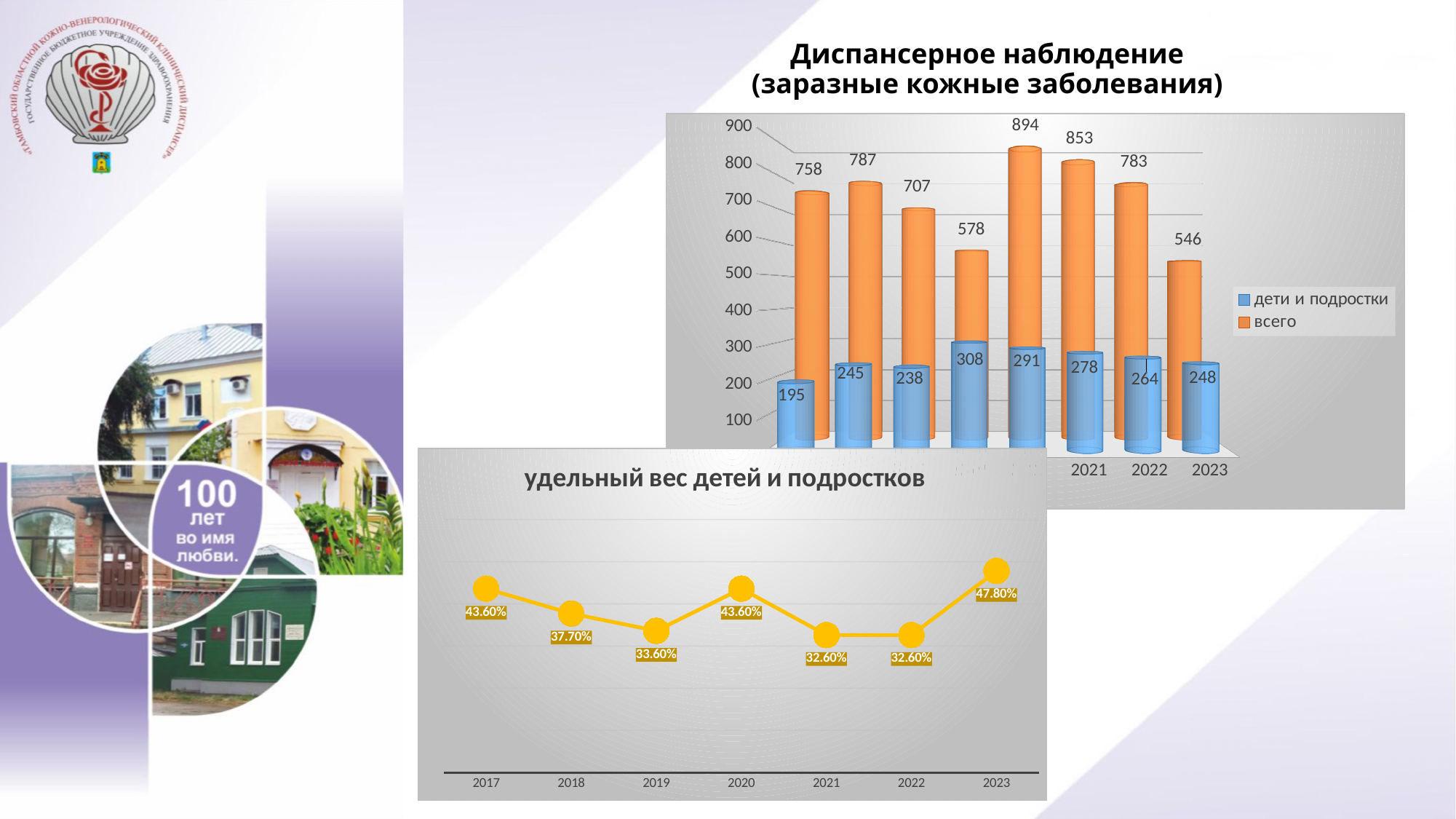
In the chart 'удельный вес детей и подростков', how many data points are plotted? 7 In the chart 'Диспансерное наблюдение (заразные кожные заболевания)', what is the value of 'дети и подростки' for 2021? 278 In the chart 'Диспансерное наблюдение (заразные кожные заболевания)', what is the value of 'всего' for 2022? 783 In the chart 'удельный вес детей и подростков', what is the value for 2018? 37.70% In the chart 'Диспансерное наблюдение (заразные кожные заболевания)', what is the difference between 'всего' and 'дети и подростки' in 2023? 298 In the chart 'Диспансерное наблюдение (заразные кожные заболевания)', which year has the lowest 'всего' value? 2023 In the chart 'удельный вес детей и подростков', is the value for 2020 larger or smaller than the value for 2021? larger What kind of chart is 'удельный вес детей и подростков'? line chart In the chart 'удельный вес детей и подростков', which year has the highest value? 2023 In the chart 'Диспансерное наблюдение (заразные кожные заболевания)', how many series does the legend list? 2 In the chart 'Диспансерное наблюдение (заразные кожные заболевания)', what is the value of 'всего' for 2023? 546 In the chart 'Диспансерное наблюдение (заразные кожные заболевания)', what is the highest value shown for the 'всего' series? 894